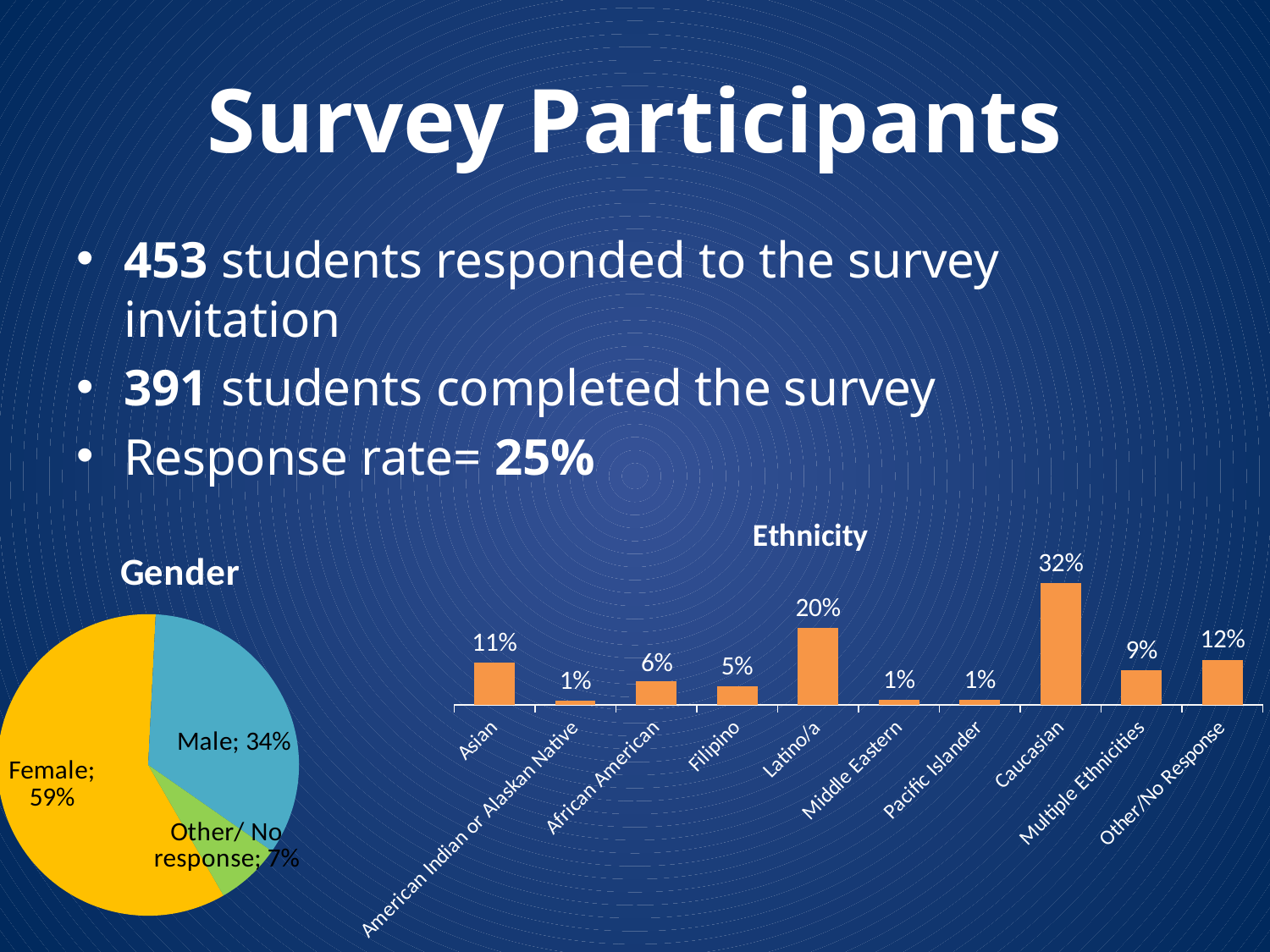
In the Gender pie chart, how many slices are there? 3 In the Ethnicity chart, what is the value for Latino/a? 20% In the Gender pie chart, what share of participants is Female? 59% In the Ethnicity chart, which category has the highest value? Caucasian In the Gender pie chart, what share of participants is Male? 34% What kind of chart is the Ethnicity chart? Bar chart In the Ethnicity chart, what is the value for Caucasian? 32% In the Ethnicity chart, which is larger, the value for Asian or the value for Filipino? Asian In the Gender pie chart, what is the difference between the Female and Male shares? 25% In the Ethnicity chart, how many categories are shown on the x axis? 10 In the Gender pie chart, which category has the smallest share? Other/ No response In the Ethnicity chart, what is the difference between the values for Other/No Response and Multiple Ethnicities? 3%